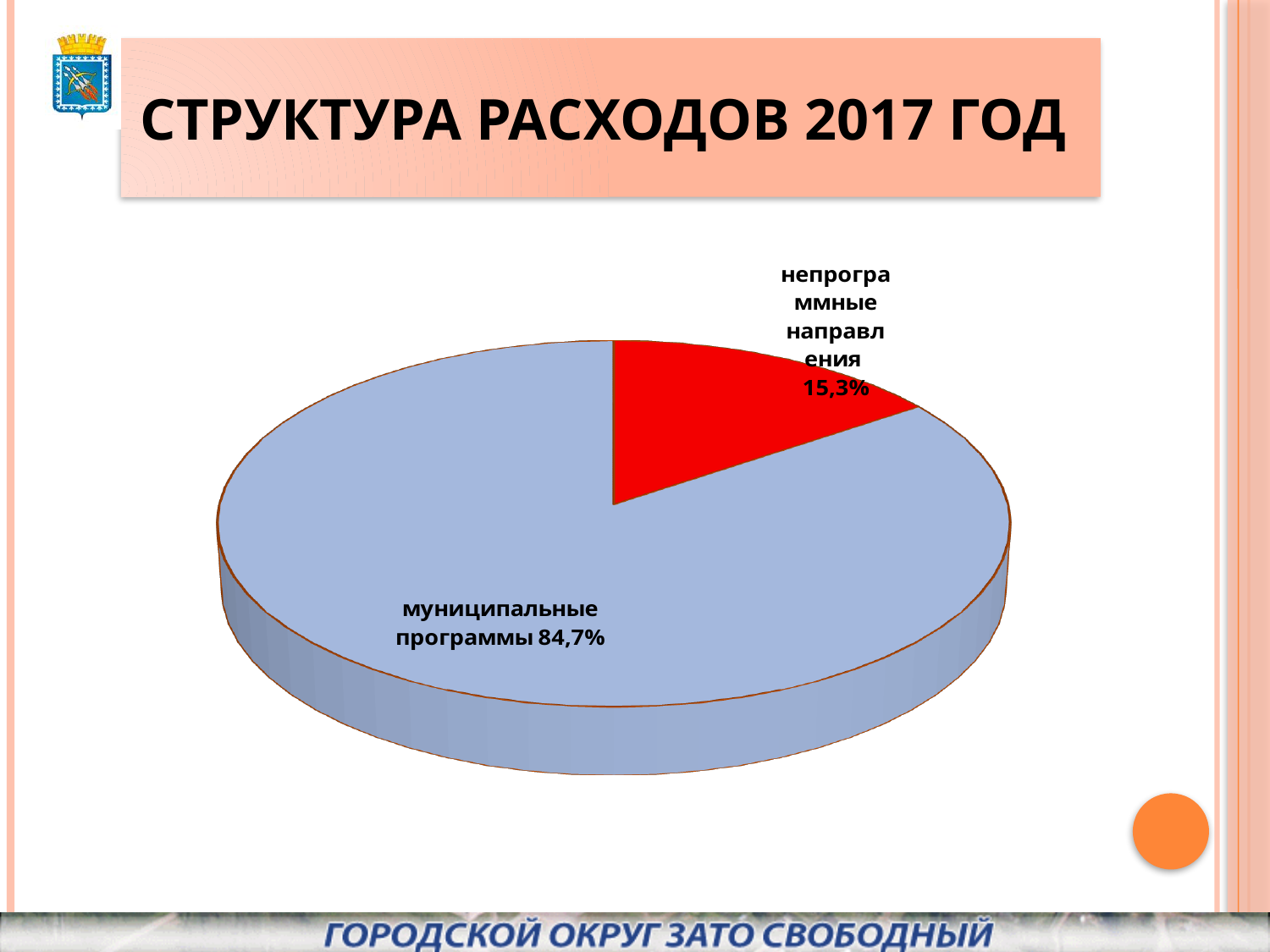
What is the title of the slide containing the chart? СТРУКТУРА РАСХОДОВ 2017 ГОД Which is larger: the share for "муниципальные программы" or for "непрограммные направления"? муниципальные программы What kind of chart is shown on the slide? pie chart What is the difference in percentage points between the "муниципальные программы" slice and the "непрограммные направления" slice? 69,4 What share of the pie is labelled "муниципальные программы"? 84,7% Which slice of the pie is the smallest? непрограммные направления Which slice of the pie is the largest? муниципальные программы How many slices does the pie chart have? 2 What colour is the "непрограммные направления" slice? red What share of the pie is labelled "непрограммные направления"? 15,3%